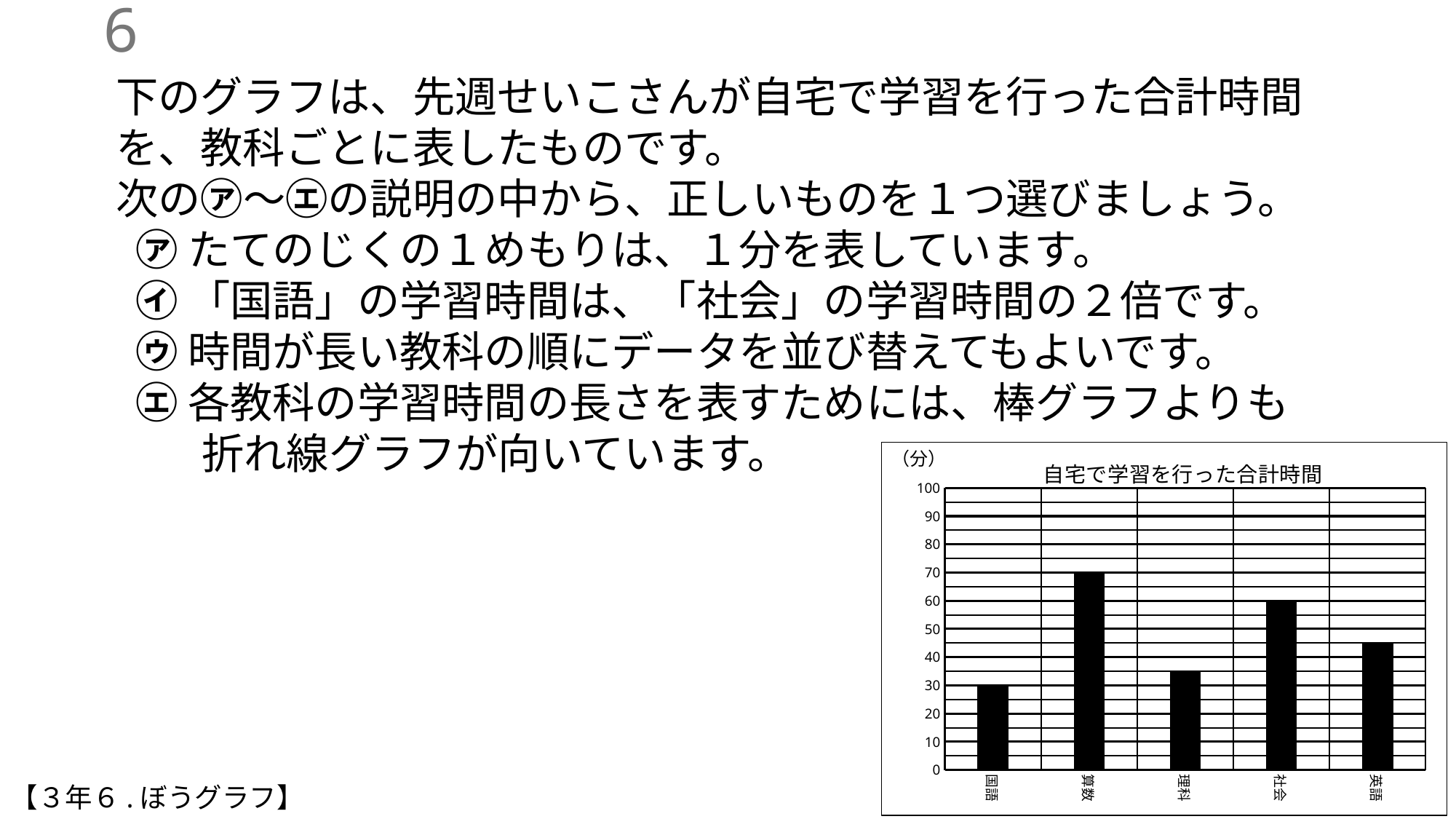
What is the study time for 社会 in the chart? 60 What is the title of the chart? 自宅で学習を行った合計時間 Which has the larger study time, 社会 or 英語? 社会 Is the value for 英語 greater or less than 40? greater What is the study time for 国語 in the chart? 30 What is the difference between the study time for 算数 and 社会? 10 What is the study time for 算数 in the chart? 70 What kind of chart is shown on the slide? bar chart How many subjects (categories) are shown in the chart? 5 Which subject has the shortest study time in the chart? 国語 Is the value for 理科 greater or less than 40? less Which subject has the longest study time in the chart? 算数